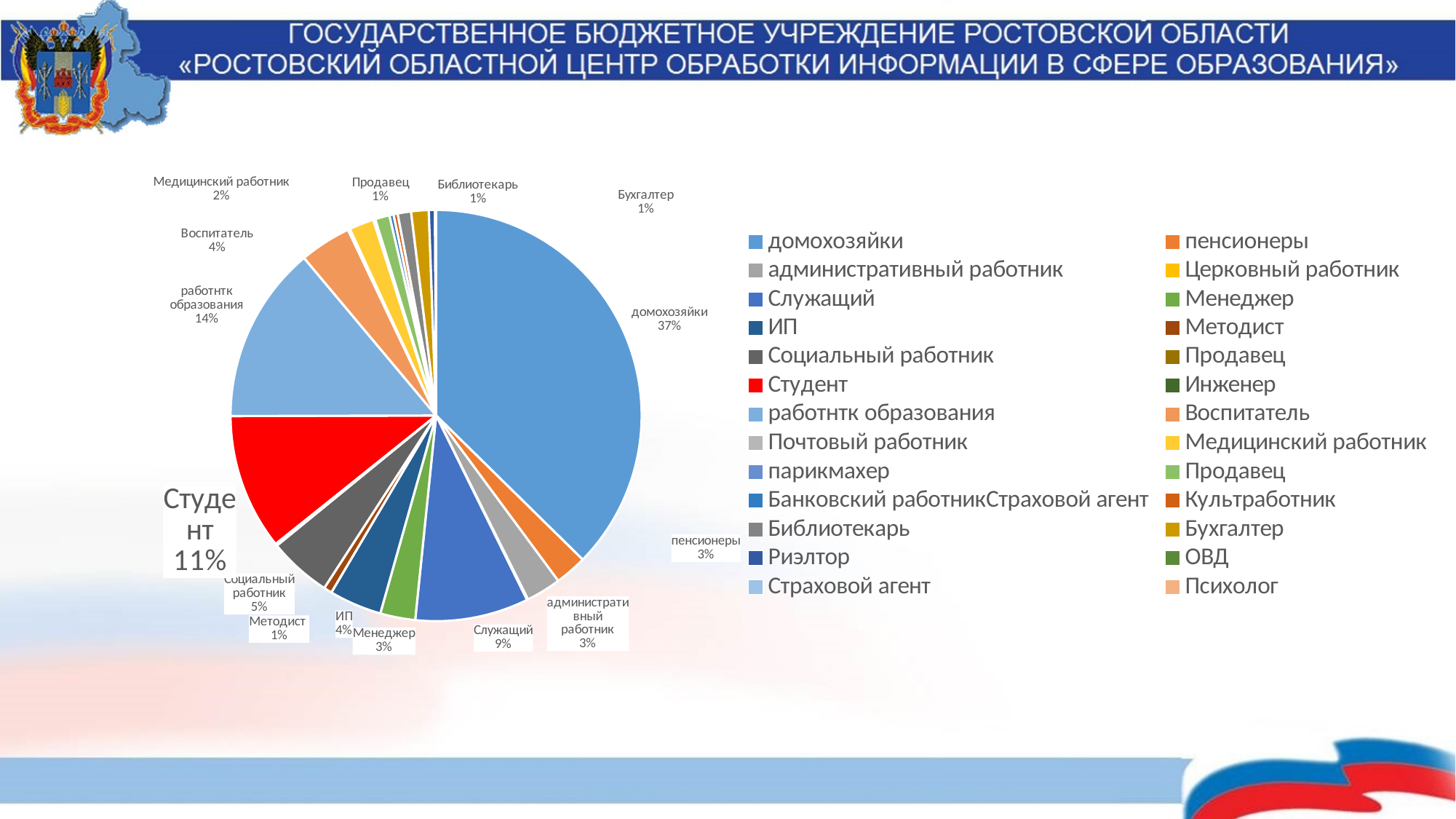
What share of the pie does Служащий have? 9% What share of the pie does домохозяйки have? 37% Which is larger, the share of ИП or the share of Медицинский работник? ИП Which category has the largest slice of the pie? домохозяйки What share of the pie does работнтк образования have? 14% What is the difference between the shares of Студент and Служащий? 2% What colour is the Студент slice in the pie chart? red Which is larger, the share of Студент or the share of Социальный работник? Студент What kind of chart is shown on the slide? pie chart What share of the pie does Студент have? 11% What share of the pie does Социальный работник have? 5% What is the difference between the shares of домохозяйки and работнтк образования? 23%